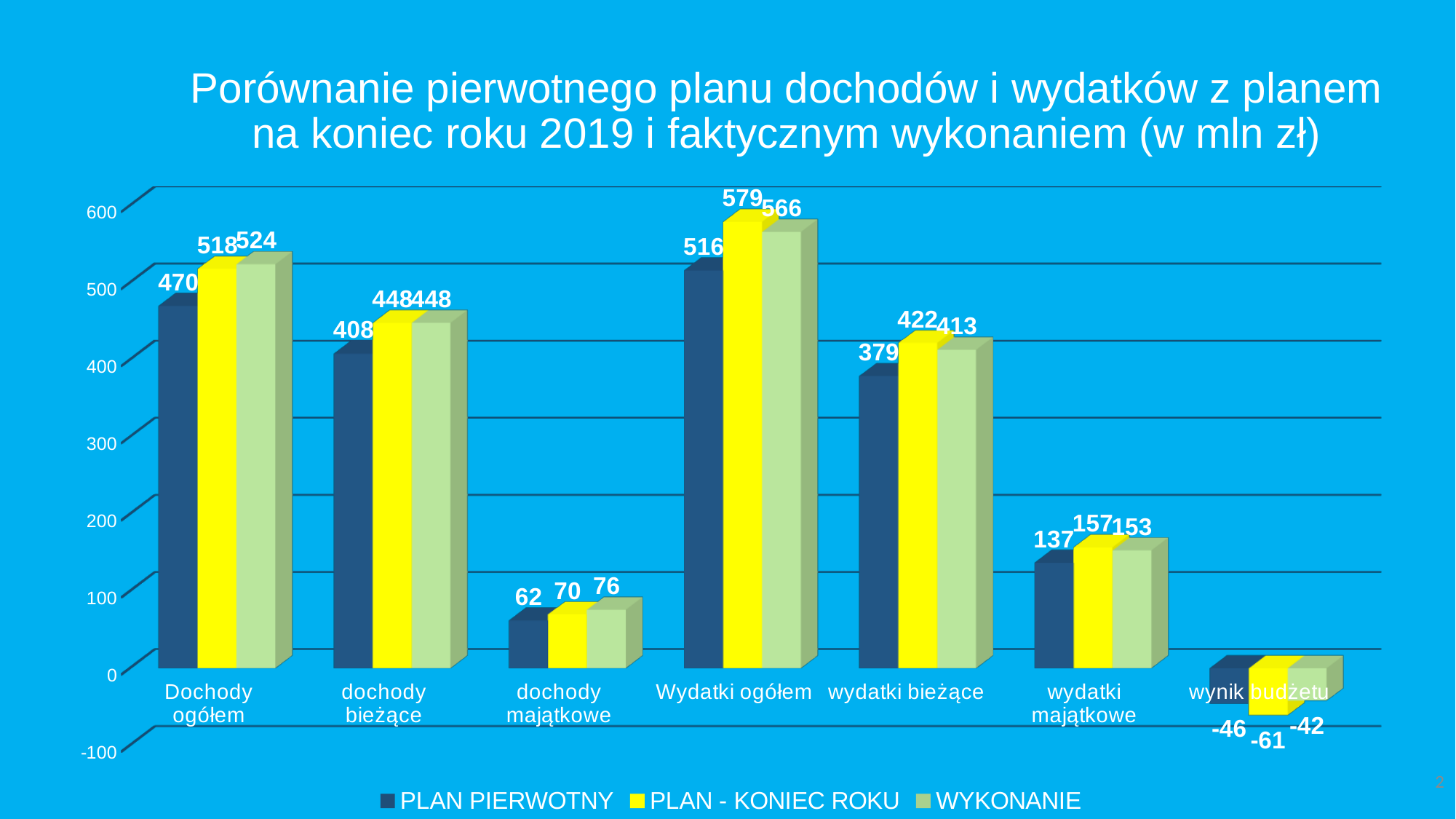
What is the WYKONANIE value for dochody majątkowe? 76 Which is larger for wydatki majątkowe: the PLAN - KONIEC ROKU value or the WYKONANIE value? PLAN - KONIEC ROKU Which series is shown in yellow in the legend? PLAN - KONIEC ROKU What is the PLAN - KONIEC ROKU value for wynik budżetu? -61 Which category has the highest PLAN - KONIEC ROKU value? Wydatki ogółem What is the WYKONANIE value for Wydatki ogółem? 566 How many series does the legend list? 3 Which category has the lowest WYKONANIE value? wynik budżetu How many categories are shown on the x axis? 7 What kind of chart is shown on the slide? Bar chart What is the PLAN PIERWOTNY value for Dochody ogółem? 470 What is the difference between the PLAN - KONIEC ROKU and PLAN PIERWOTNY values for wydatki bieżące? 43